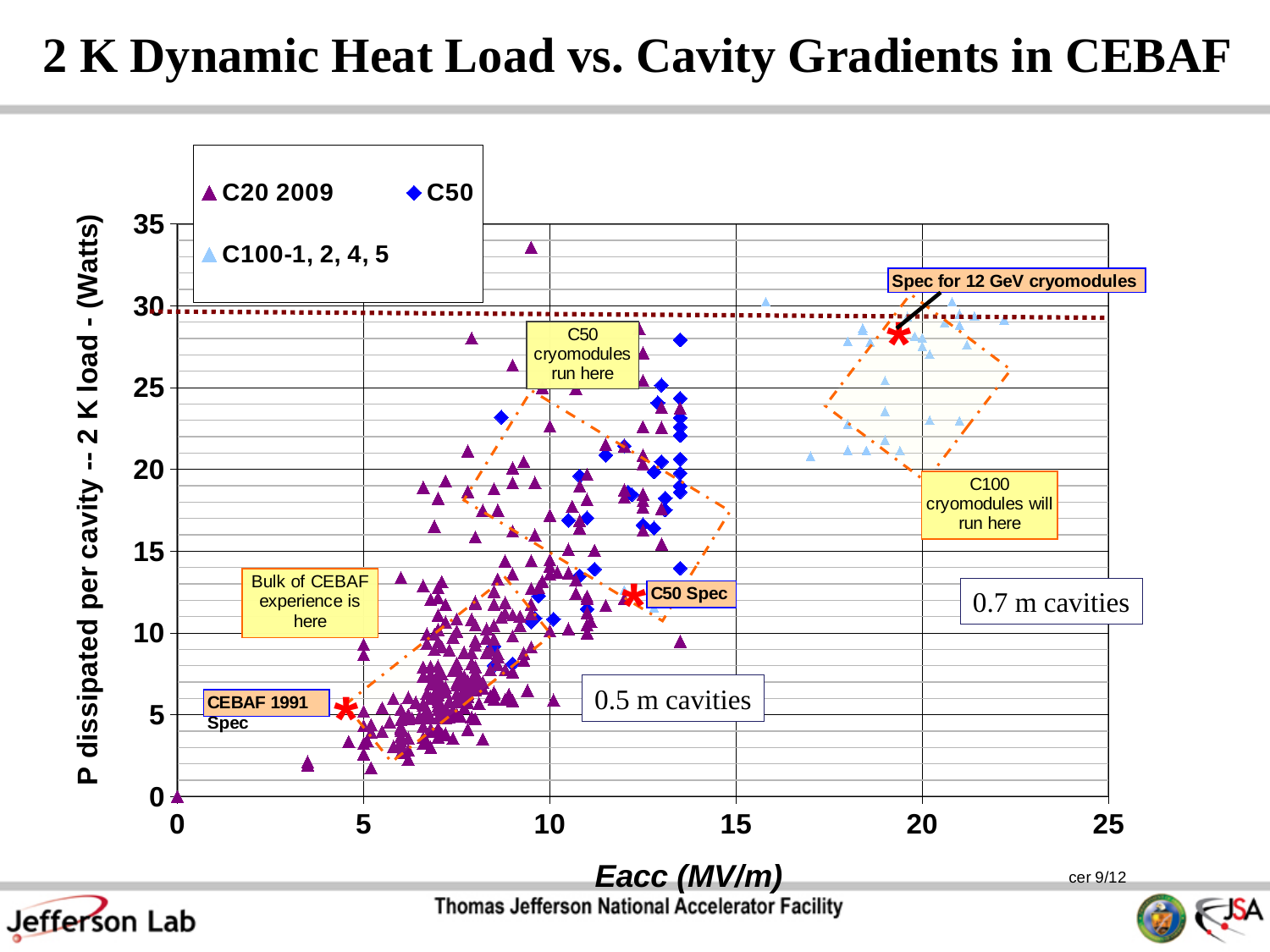
Which series has the points with the highest Eacc values? C100-1, 2, 4, 5 Is the Eacc value of the Spec for 12 GeV cryomodules marker greater or less than 15 MV/m? greater Is the Eacc value of the C50 Spec marker greater or less than 15 MV/m? less What is the label of the x axis? Eacc (MV/m) What are the three series named in the legend? C20 2009, C50, C100-1, 2, 4, 5 Does the dissipated power per cavity generally rise or fall as Eacc increases? rise Is the dissipated power of the Spec for 12 GeV cryomodules marker greater or less than 25 Watts? greater Which series has the points with the lowest Eacc values? C20 2009 What kind of chart is shown on the slide? Scatter plot Which has the larger Eacc value, the C50 Spec marker or the Spec for 12 GeV cryomodules marker? Spec for 12 GeV cryomodules How many series does the legend list? 3